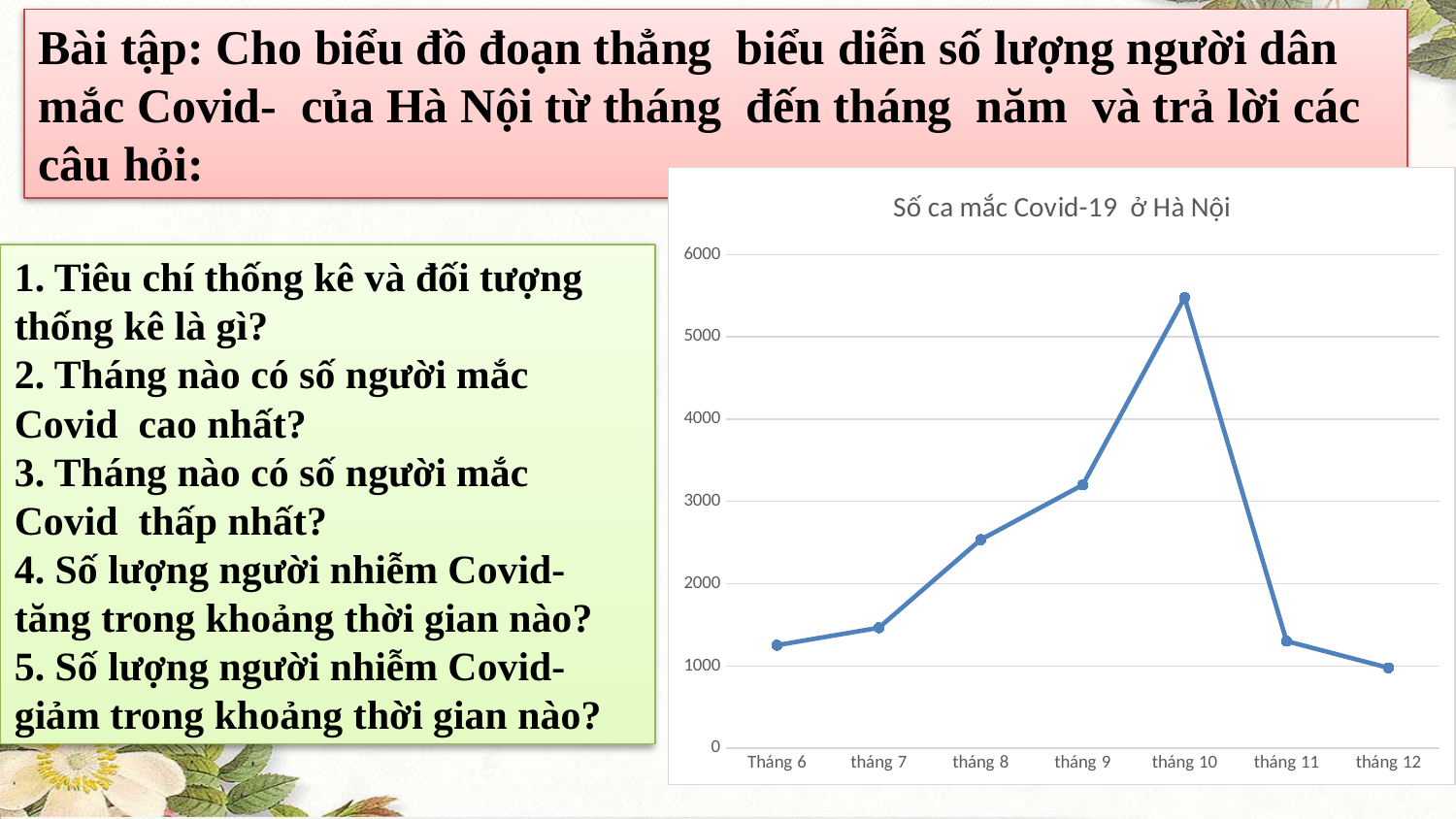
Is the value for tháng 8 greater or less than 2000? greater Do the values rise or fall from tháng 10 to tháng 12? fall Which month has the lowest number of Covid-19 cases in the chart? tháng 12 Which month has more Covid-19 cases, tháng 7 or tháng 8? tháng 8 Is the value for Tháng 6 greater or less than 2000? less How many months are plotted on the x axis of the chart? 7 What is the title of the chart? Số ca mắc Covid-19 ở Hà Nội Is the value for tháng 10 greater or less than 5000? greater What kind of chart is shown on the slide? line chart Do the values rise or fall from Tháng 6 to tháng 10? rise Which month has the highest number of Covid-19 cases in the chart? tháng 10